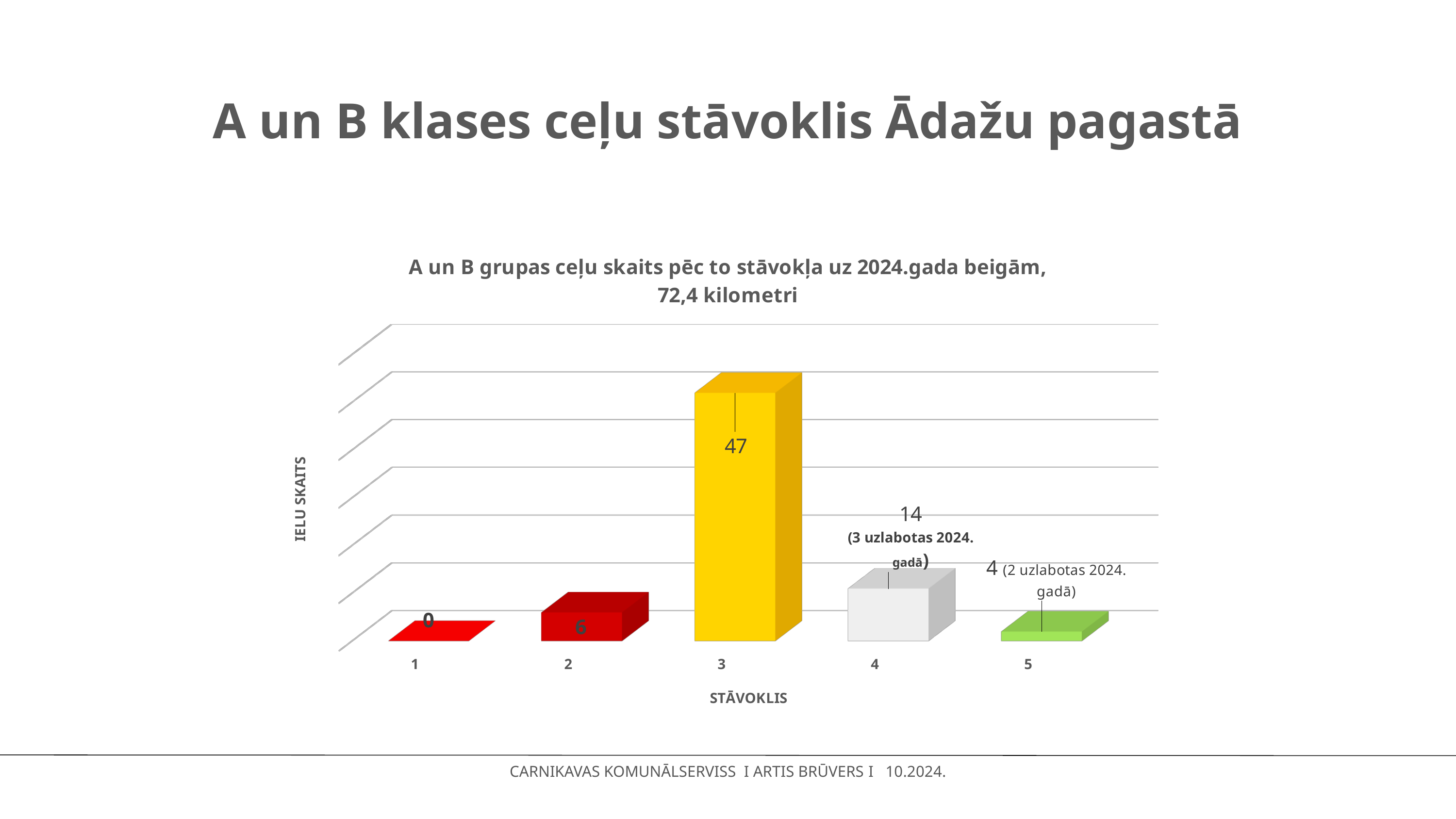
Which category has the highest value? 3 Which is larger, the value for category 2 or the value for category 5? category 2 Which category has the lowest value? 1 What is the value for category 1? 0 What is the label of the x axis? STĀVOKLIS How many categories are shown on the x axis? 5 What is the value for category 2? 6 What kind of chart is shown on the slide? bar chart What is the value for category 3? 47 What is the difference between the values for category 3 and category 4? 33 What is the value for category 5? 4 What is the value for category 4? 14